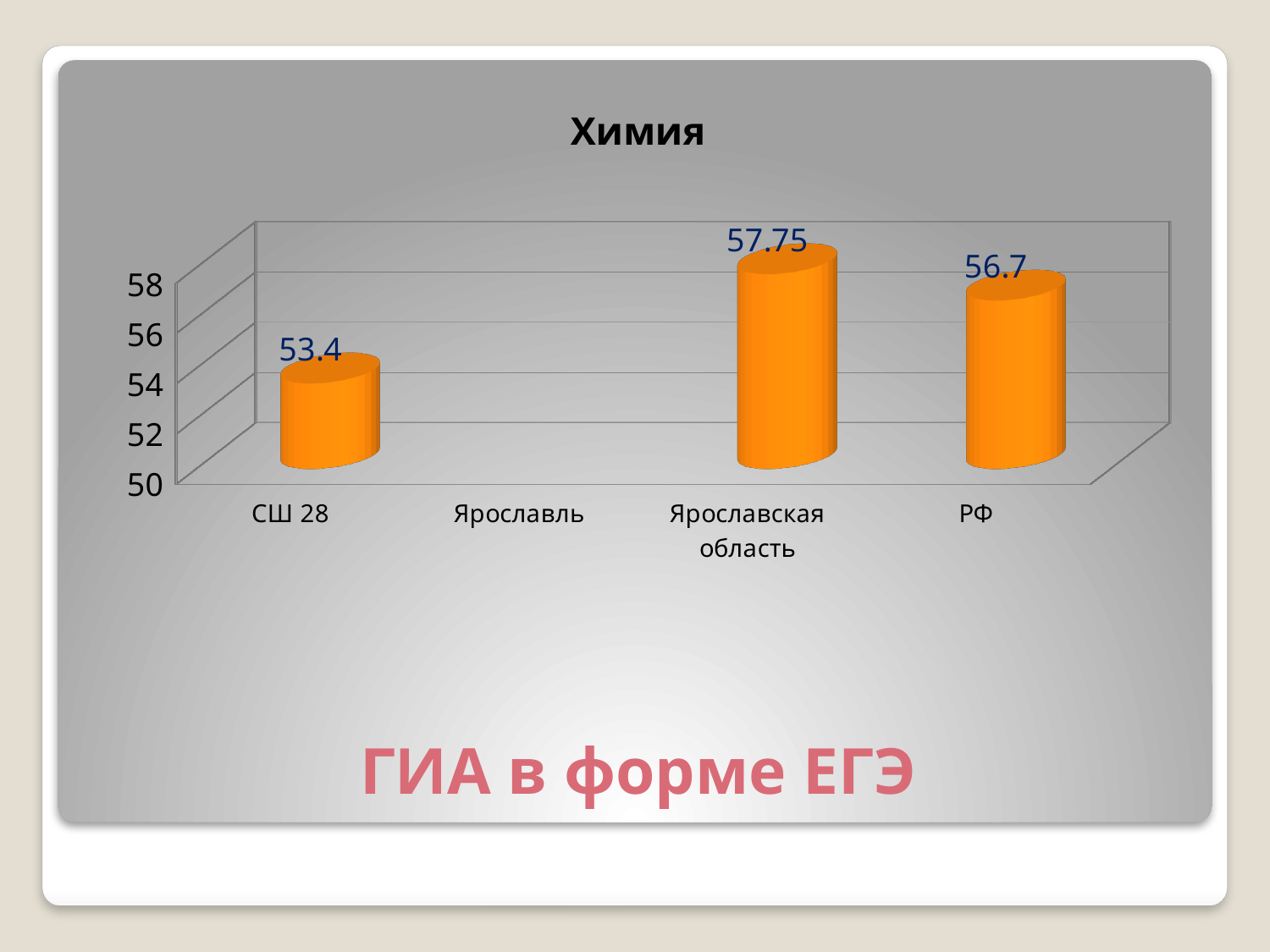
What is the value for РФ? 56.7 What kind of chart is shown on the slide? bar chart What is the value for Ярославская область? 57.75 Is the value for СШ 28 greater or less than 54? less What is the title of the chart? Химия Which category has the highest value? Ярославская область Which category with a plotted bar has the lowest value? СШ 28 What is the difference between the values for Ярославская область and СШ 28? 4.35 What is the value for СШ 28? 53.4 Which is larger, the value for РФ or the value for СШ 28? РФ What is the difference between the values for Ярославская область and РФ? 1.05 How many categories are labelled on the x axis? 4